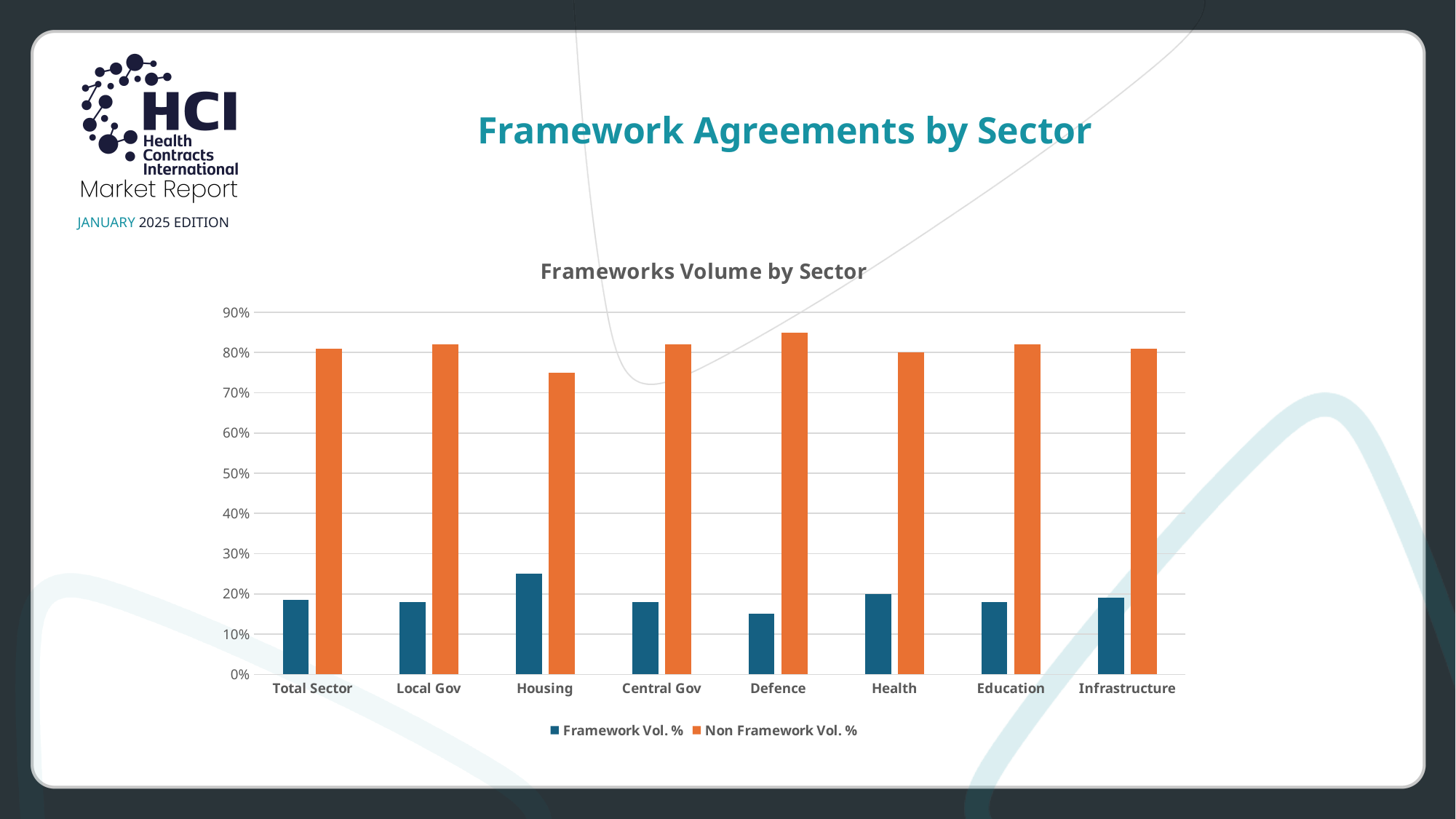
Which sector has the highest Non Framework Vol. %? Defence What is the title of the chart? Frameworks Volume by Sector Which sector has the lowest Non Framework Vol. %? Housing Which sector has the highest Framework Vol. %? Housing Which is larger: the Framework Vol. % for Housing or for Health? Housing Is the Framework Vol. % for Housing greater or less than 20%? greater How many series does the chart legend list? 2 What kind of chart is shown on the slide? Bar chart Is the Non Framework Vol. % for Housing greater or less than 80%? less How many sectors are shown on the x axis of the chart? 8 Is the Framework Vol. % for Defence greater or less than 20%? less Which sector has the lowest Framework Vol. %? Defence